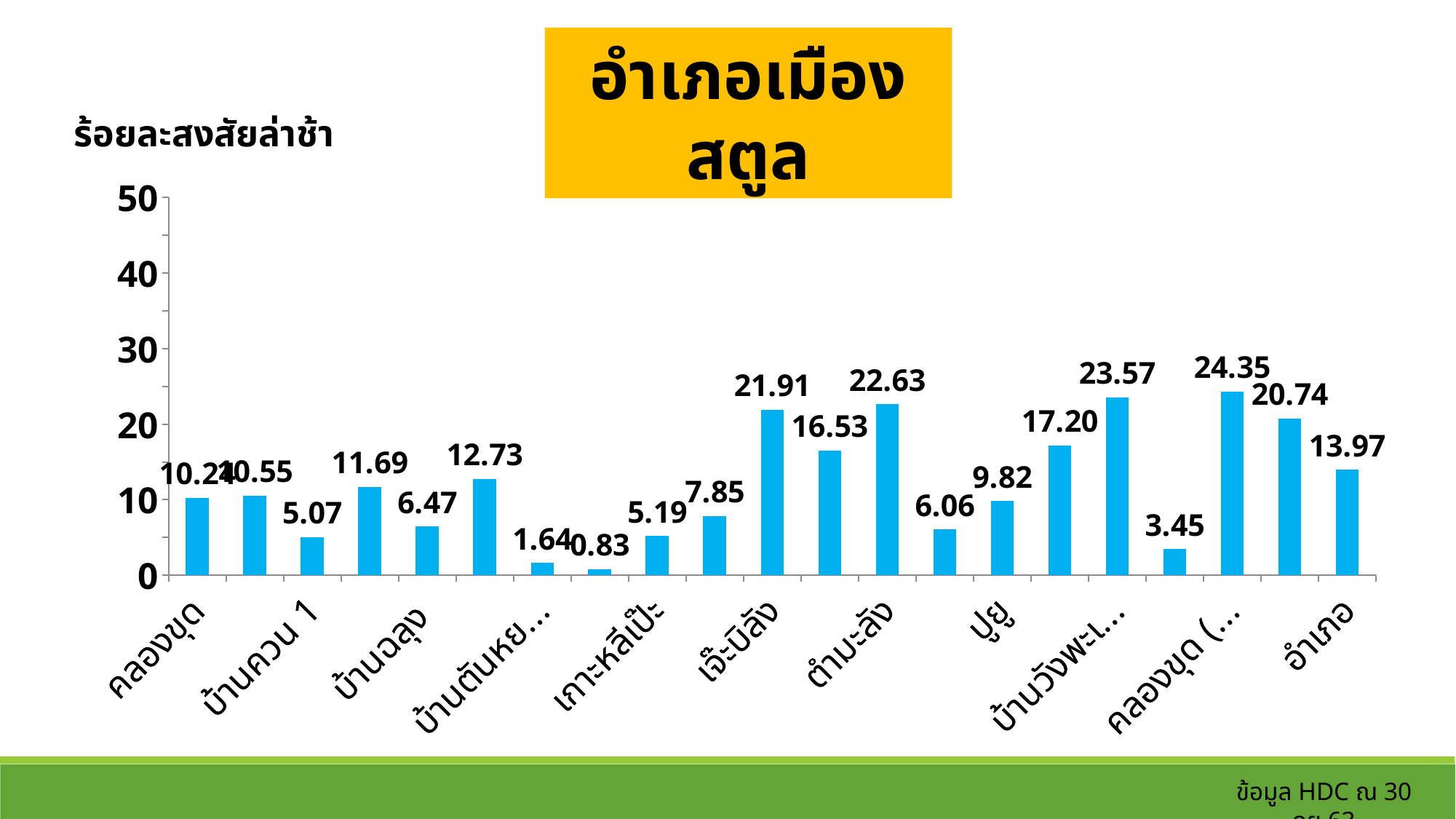
What is the value for คลองขุด (the first bar)? 10.24 What is the title shown in the yellow box above the chart? อำเภอเมืองสตูล What is the value for ตำมะลัง? 22.63 What is the value for อำเภอ (the last bar)? 13.97 What is the lowest value shown on the chart? 0.83 Which has a larger value, บ้านฉลุง or เกาะหลีเป๊ะ? บ้านฉลุง What is the difference between the values for ตำมะลัง and เจ๊ะบิลัง? 0.72 What type of chart is shown on the slide? bar chart What is the highest value shown on the chart? 24.35 What is the value for ปูยู? 9.82 What is the value for เจ๊ะบิลัง? 21.91 How many bars are plotted on the chart? 21